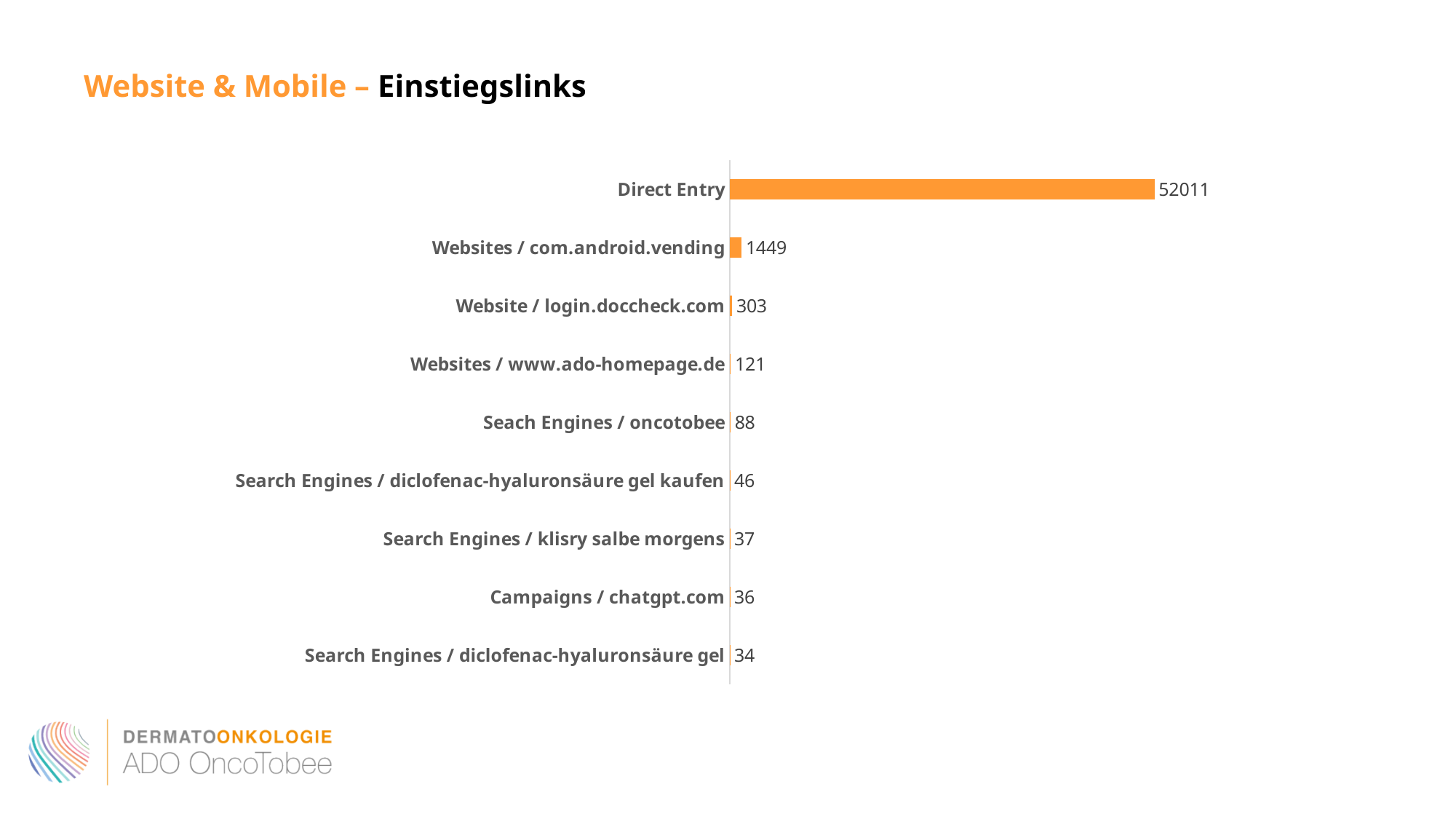
What is the title of the slide? Website & Mobile – Einstiegslinks What is the difference between the values for Websites / www.ado-homepage.de and Seach Engines / oncotobee? 33 Which category has the lowest value? Search Engines / diclofenac-hyaluronsäure gel What is the value for Direct Entry? 52011 What is the value for Campaigns / chatgpt.com? 36 What is the value for Website / login.doccheck.com? 303 What kind of chart is shown on the slide? Bar chart Which is larger, the value for Search Engines / klisry salbe morgens or the value for Campaigns / chatgpt.com? Search Engines / klisry salbe morgens Which category has the highest value? Direct Entry How many categories are shown in the chart? 9 What is the difference between the values for Direct Entry and Websites / com.android.vending? 50562 What is the value for Websites / com.android.vending? 1449